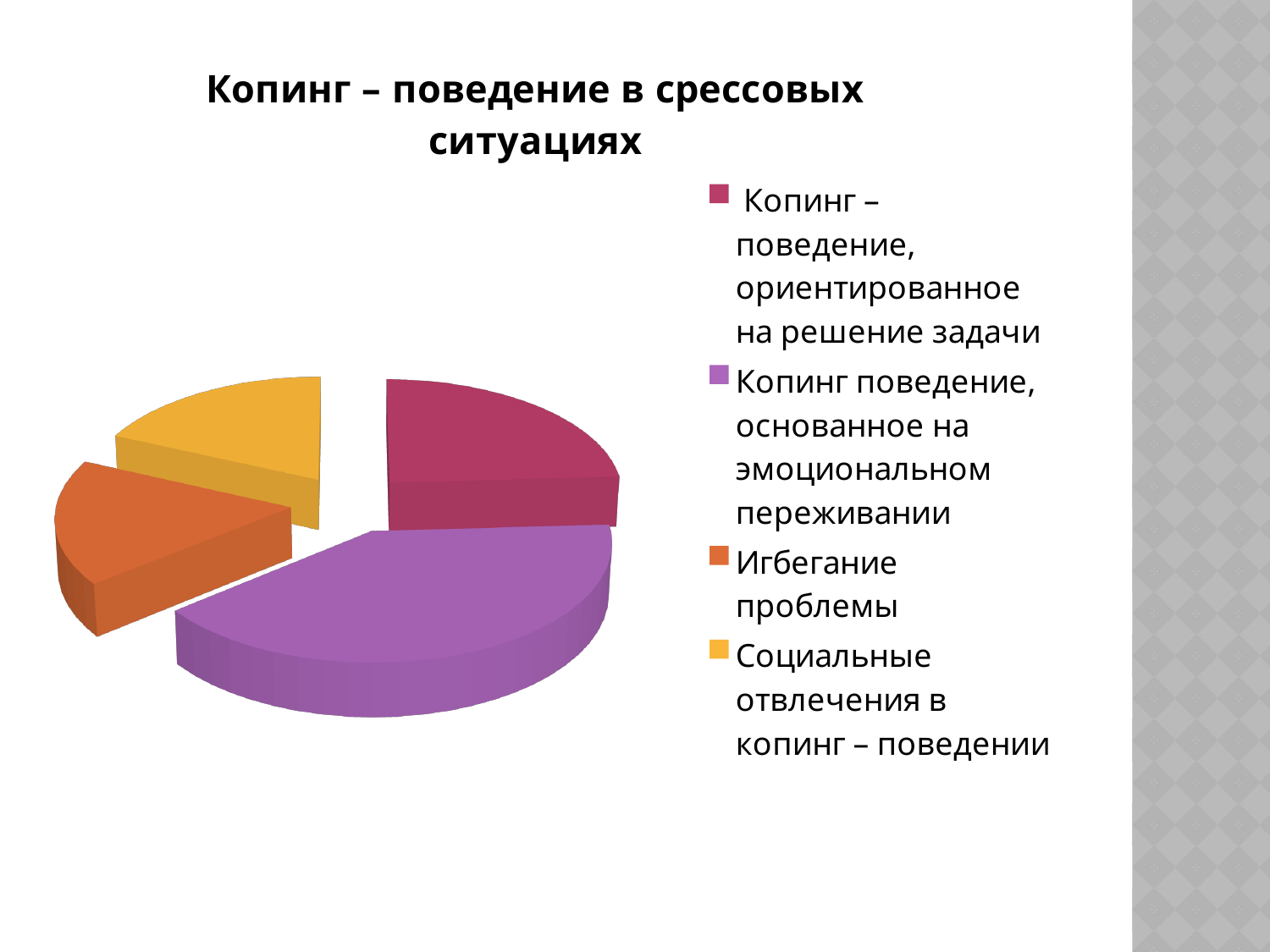
How many slices does the pie chart have? 4 Which category has the largest slice of the pie chart? Копинг поведение, основанное на эмоциональном переживании Which slice is larger: "Копинг поведение, основанное на эмоциональном переживании" or "Социальные отвлечения в копинг – поведении"? Копинг поведение, основанное на эмоциональном переживании What is the title of the chart on the slide? Копинг – поведение в срессовых ситуациях How many entries does the legend of the pie chart list? 4 Which slice is larger: "Копинг поведение, основанное на эмоциональном переживании" or "Игбегание проблемы"? Копинг поведение, основанное на эмоциональном переживании Which slice is larger: "Копинг поведение, основанное на эмоциональном переживании" or "Копинг – поведение, ориентированное на решение задачи"? Копинг поведение, основанное на эмоциональном переживании What colour is the slice for "Социальные отвлечения в копинг – поведении"? Yellow What kind of chart is shown on the slide? Pie chart